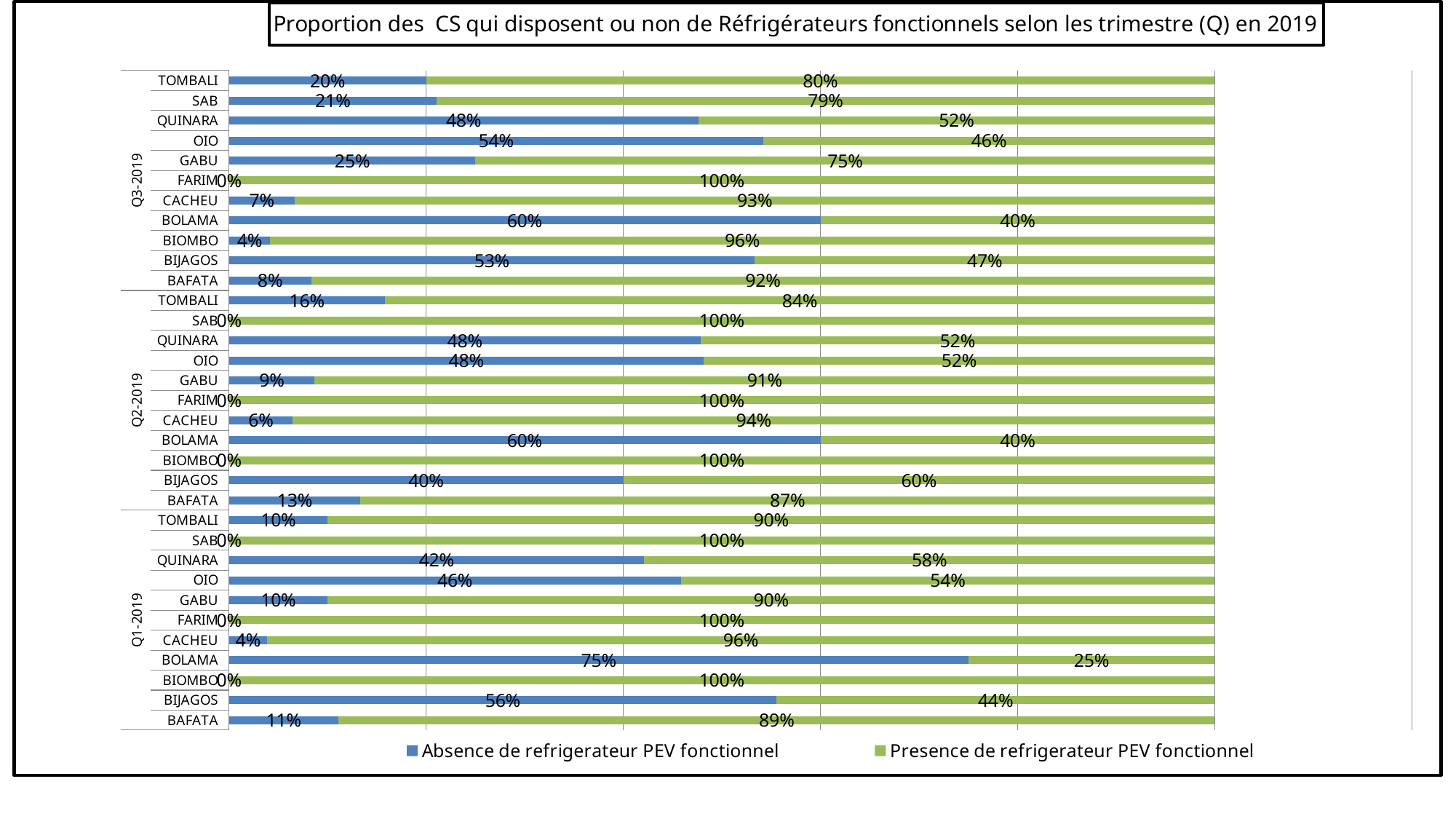
What kind of chart is shown on the slide? Stacked bar chart In Q3-2019, what is the difference between the 'Absence' and 'Presence' values for OIO? 8 percentage points Which colour represents 'Presence de refrigerateur PEV fonctionnel' in the legend? Green What is the total of the stacked bar for GABU in Q2-2019? 100% What is the value of 'Absence de refrigerateur PEV fonctionnel' for TOMBALI in Q3-2019? 20% How many regions are listed within each quarter group? 11 In Q1-2019, which has the larger 'Absence de refrigerateur PEV fonctionnel' value, QUINARA or OIO? OIO How many series does the legend list? 2 What is the value of 'Presence de refrigerateur PEV fonctionnel' for BIJAGOS in Q2-2019? 60% In Q3-2019, which region has the lowest value for 'Presence de refrigerateur PEV fonctionnel'? BOLAMA In Q1-2019, which region has the highest value for 'Absence de refrigerateur PEV fonctionnel'? BOLAMA What is the value of 'Absence de refrigerateur PEV fonctionnel' for BOLAMA in Q1-2019? 75%